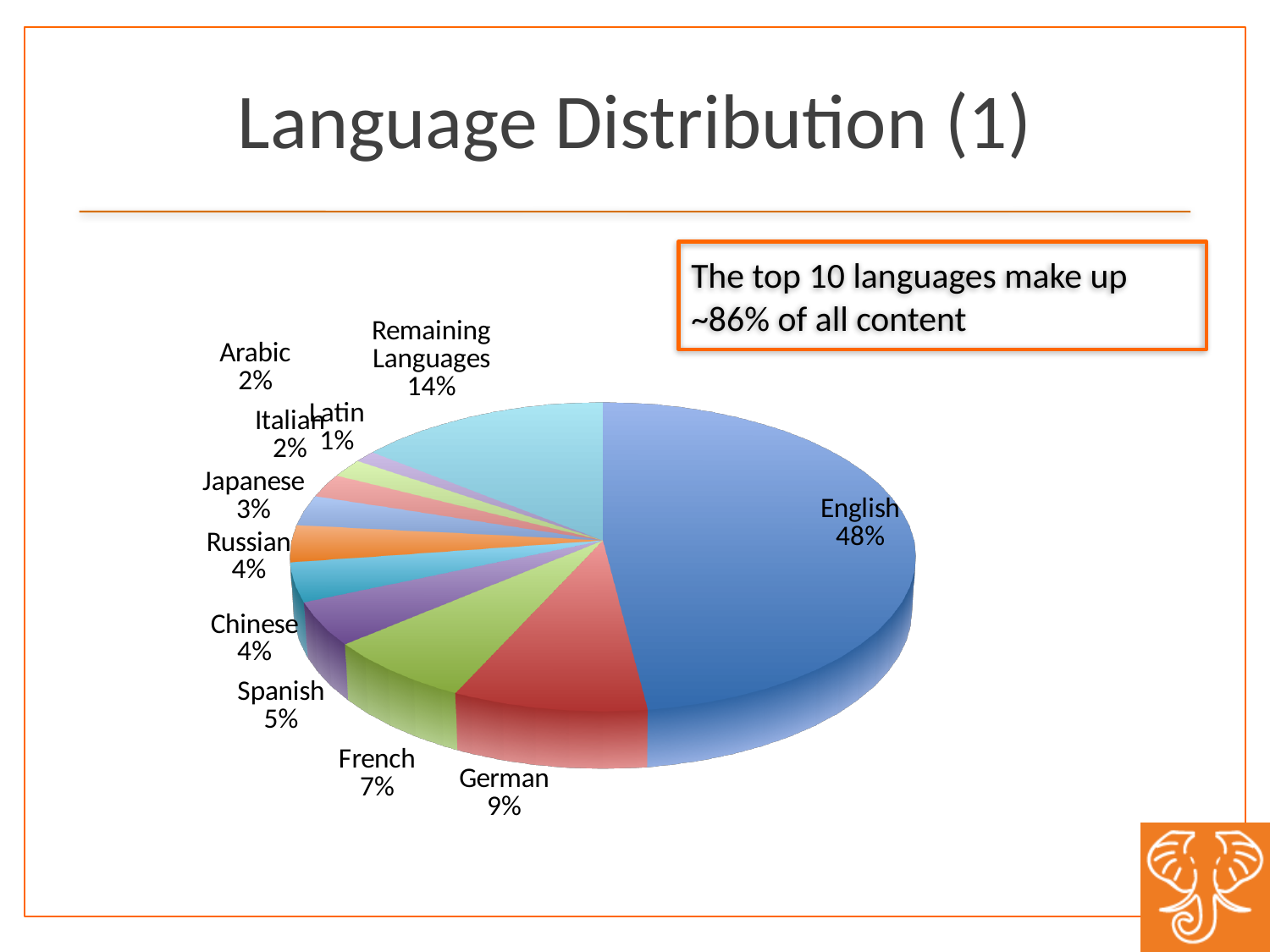
What is the value shown for German? 9% Which slice of the pie is the largest? English What is the value shown for Remaining Languages? 14% How many slices does the pie chart have? 11 What kind of chart is shown on the slide? pie chart What is the difference between the shares for English and German? 39% What is the value shown for Japanese? 3% What share of the pie does English account for? 48% Which language has the smallest slice of the pie? Latin Which is larger, the share for French or the share for Chinese? French What is the title of the slide containing the pie chart? Language Distribution (1) What is the difference between the shares for French and Spanish? 2%